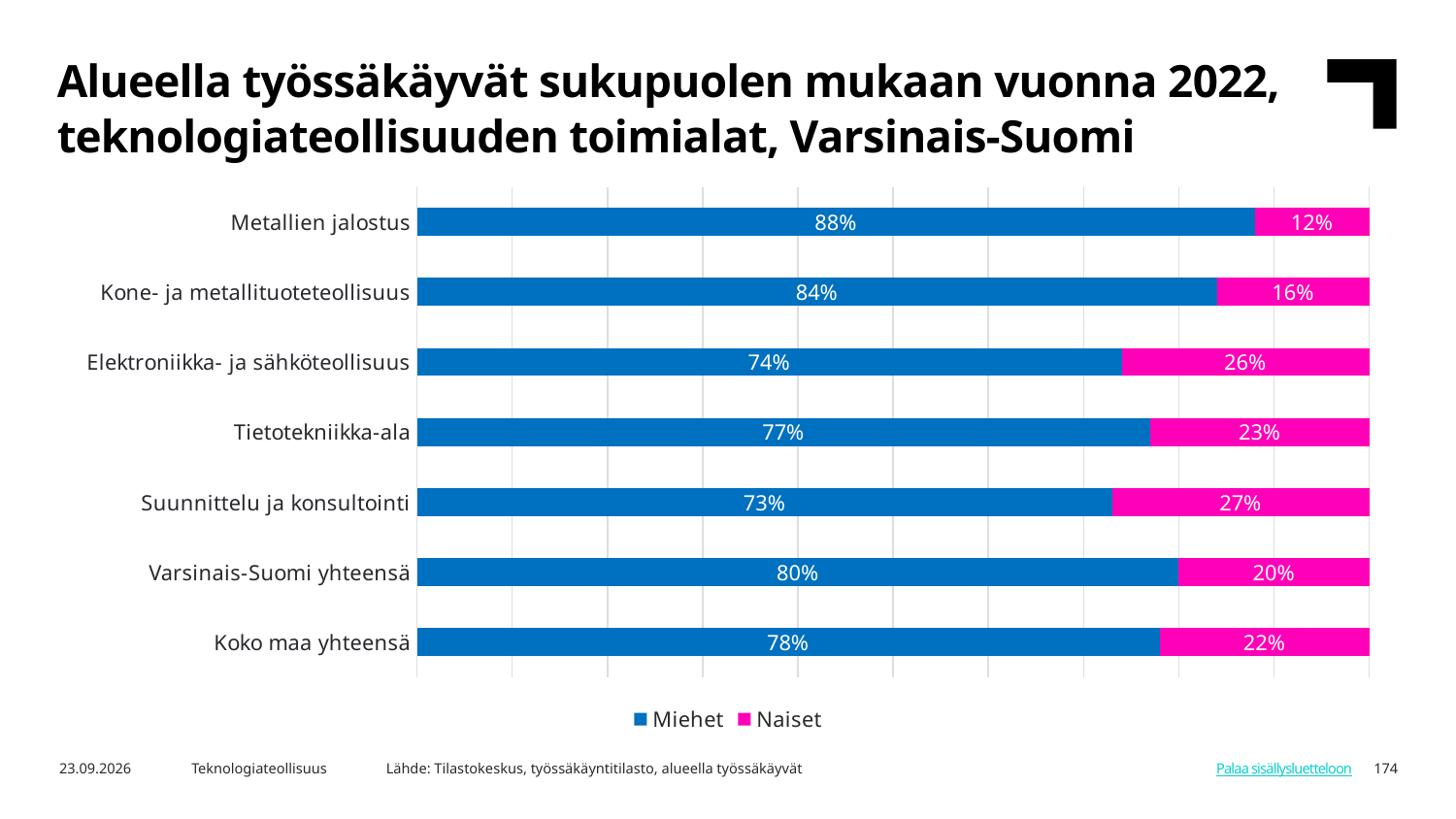
What is the Naiset share for Koko maa yhteensä? 22% What is the Naiset share for Elektroniikka- ja sähköteollisuus? 26% Which category has the lowest Miehet share? Suunnittelu ja konsultointi Which category has the highest Naiset share? Suunnittelu ja konsultointi How many series does the legend list? 2 What is the Miehet share for Varsinais-Suomi yhteensä? 80% What is the difference between the Miehet share for Kone- ja metallituoteteollisuus and for Tietotekniikka-ala? 7 percentage points What is the total of the stacked bar for Metallien jalostus? 100% What is the Miehet share for Metallien jalostus? 88% Which is larger: the Naiset share for Tietotekniikka-ala or for Varsinais-Suomi yhteensä? Tietotekniikka-ala How many categories are shown on the chart? 7 What kind of chart is shown on the slide? Stacked bar chart